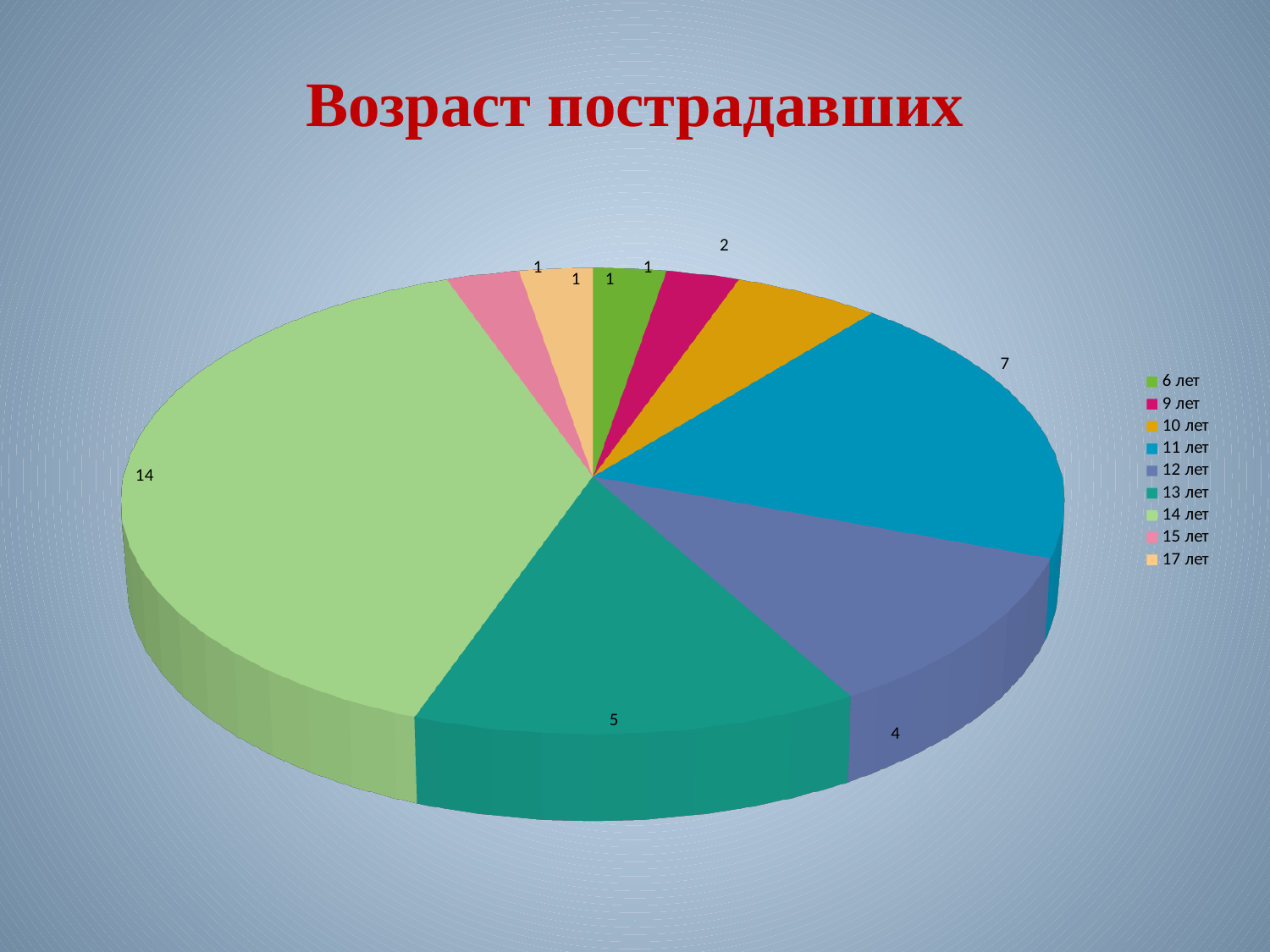
What kind of chart is shown on the slide? Pie chart What is the value for the 12 лет slice? 4 What is the title of the chart? Возраст пострадавших Which is larger, the value for 13 лет or the value for 12 лет? 13 лет How many age categories are shown in the pie chart? 9 What is the value for the 14 лет slice? 14 What is the value for the 13 лет slice? 5 Which age category has the largest slice? 14 лет What is the value for the 10 лет slice? 2 What is the total of all slices in the pie chart? 36 What is the value for the 11 лет slice? 7 What is the difference between the values for 14 лет and 11 лет? 7